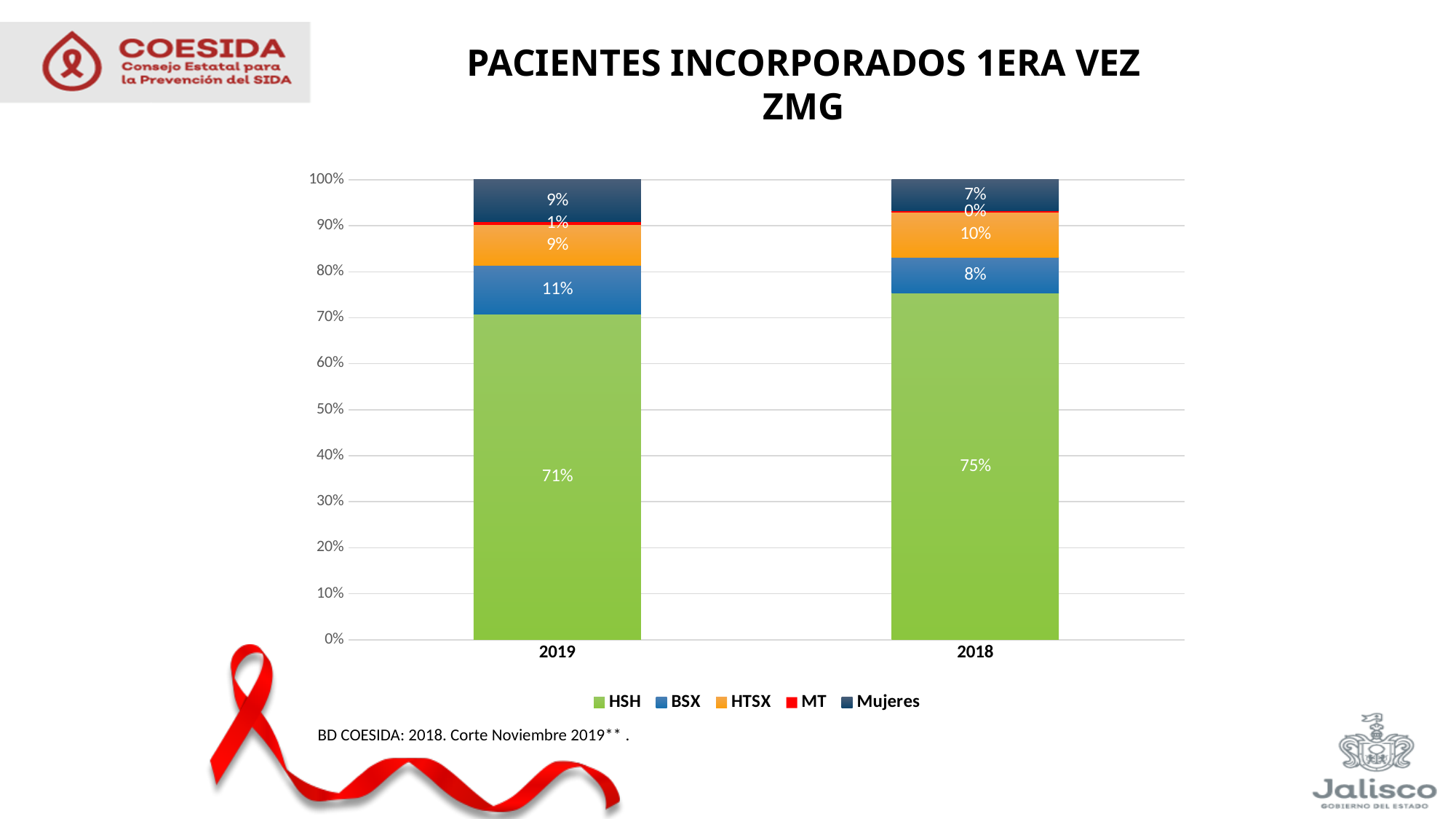
What kind of chart is shown on the slide? Stacked bar chart What is the HSH value for 2019? 71% What is the title of the chart? PACIENTES INCORPORADOS 1ERA VEZ ZMG How many categories are shown on the x axis? 2 How many series does the legend list? 5 What is the BSX value for 2019? 11% What is the MT value for 2018? 0% What is the HTSX value for 2018? 10% What is the difference between the BSX values for 2019 and 2018? 3% What is the HSH value for 2018? 75% What is the Mujeres value for 2019? 9% Which year has the higher HSH value, 2019 or 2018? 2018